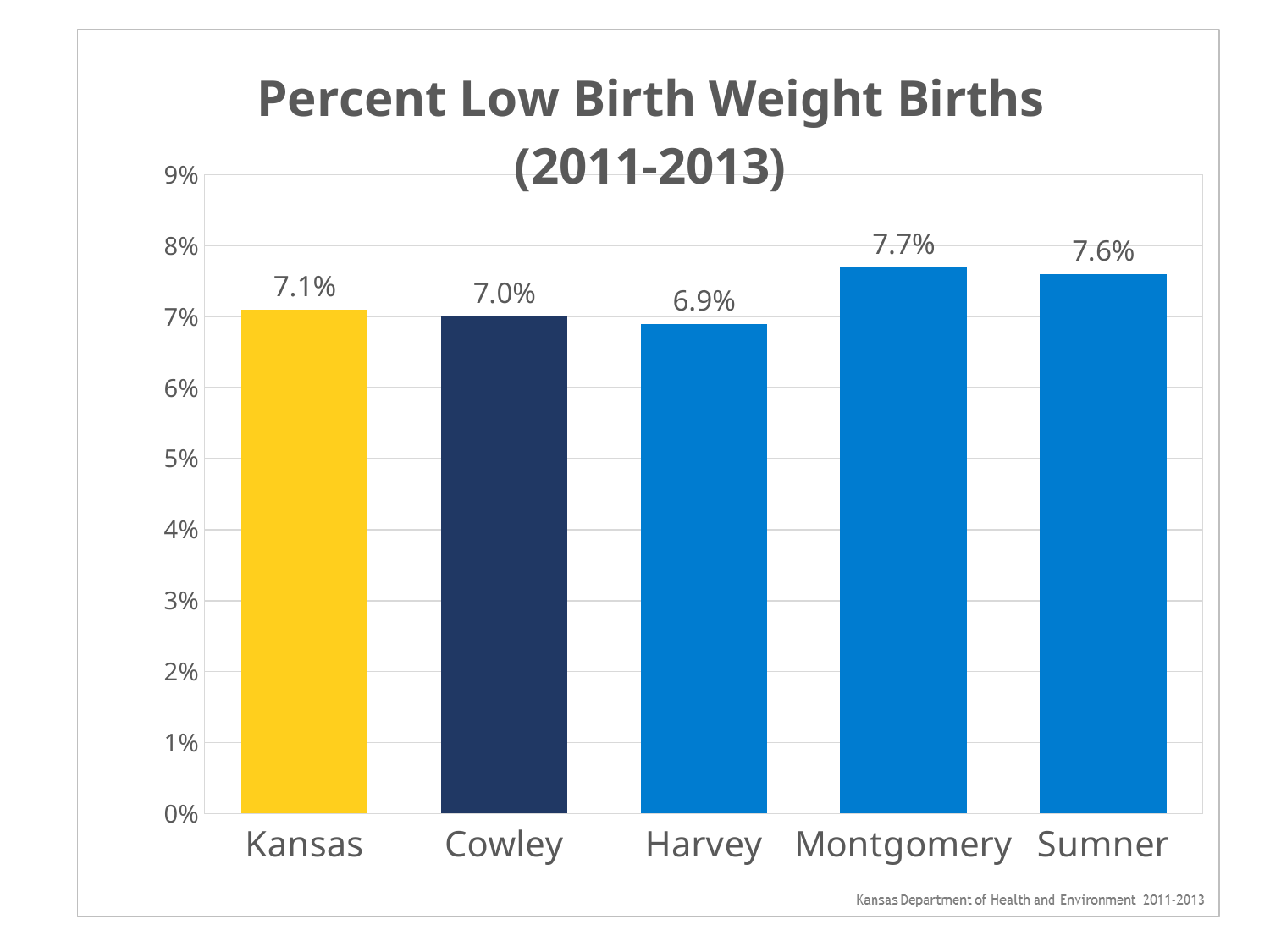
Is the value for Montgomery greater or less than 7%? greater What is the difference between the values for Sumner and Cowley? 0.6% What is the percent of low birth weight births for Harvey? 6.9% Which category has the highest percent of low birth weight births? Montgomery What is the difference between the values for Montgomery and Harvey? 0.8% What is the title of the chart? Percent Low Birth Weight Births (2011-2013) What is the percent of low birth weight births for Kansas? 7.1% What is the percent of low birth weight births for Montgomery? 7.7% Which category has the lowest percent of low birth weight births? Harvey Which is larger, the value for Sumner or the value for Kansas? Sumner How many categories are shown on the x axis? 5 What kind of chart is shown on the slide? bar chart